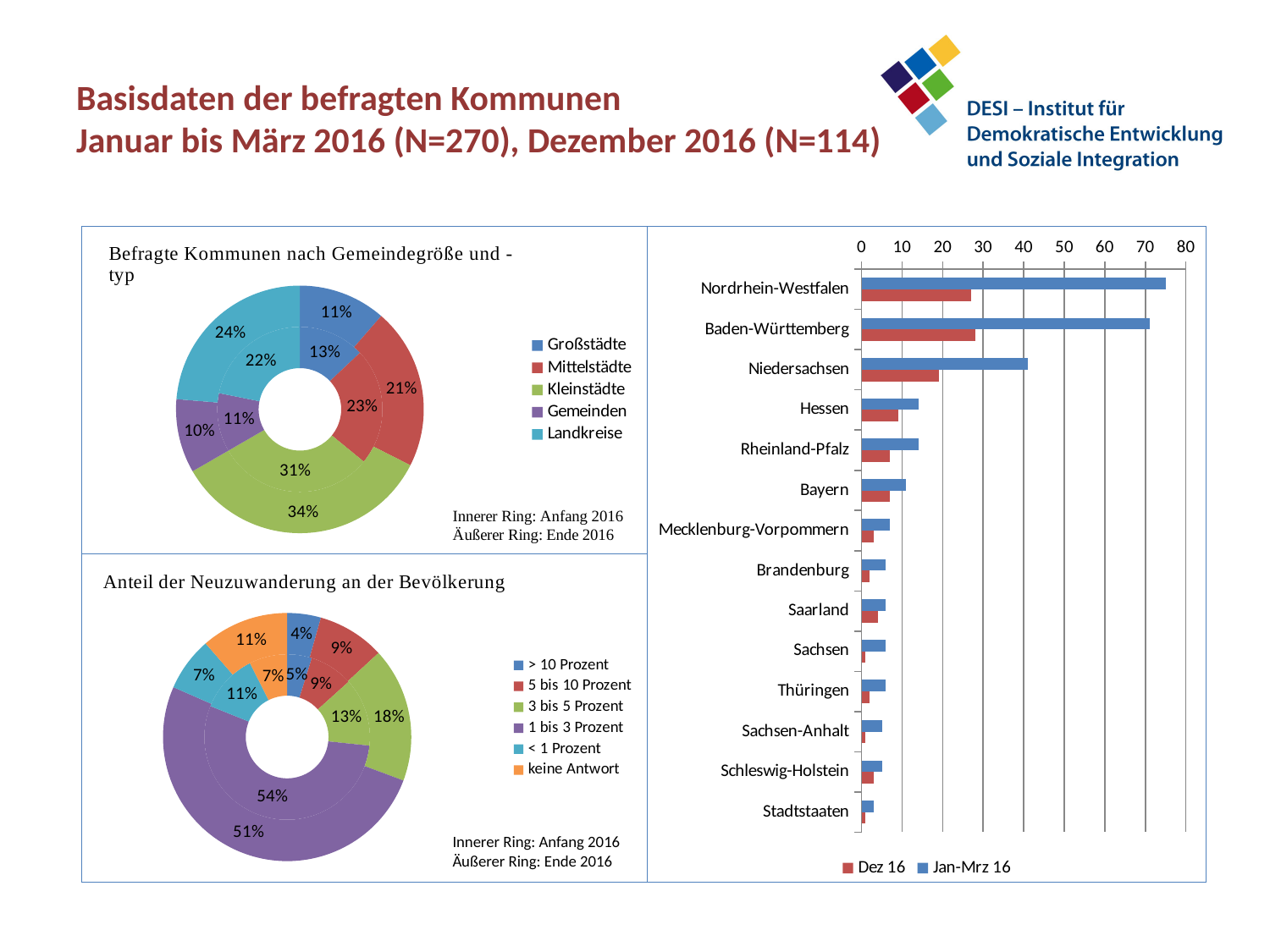
In the doughnut chart 'Befragte Kommunen nach Gemeindegröße und -typ', by how many percentage points did the share of Kleinstädte change from the inner ring (Anfang 2016) to the outer ring (Ende 2016)? 3 percentage points In the doughnut chart 'Befragte Kommunen nach Gemeindegröße und -typ', what is the share of Kleinstädte in the outer ring (Ende 2016)? 34% In the doughnut chart 'Anteil der Neuzuwanderung an der Bevölkerung', what is the share of '3 bis 5 Prozent' in the outer ring (Ende 2016)? 18% In the bar chart on the right, which federal state has the highest value for Jan-Mrz 16? Nordrhein-Westfalen In the doughnut chart 'Anteil der Neuzuwanderung an der Bevölkerung', which is larger in the outer ring (Ende 2016): '3 bis 5 Prozent' or '< 1 Prozent'? 3 bis 5 Prozent What kind of chart is the chart on the right side of the slide showing the federal states? Bar chart In the doughnut chart 'Befragte Kommunen nach Gemeindegröße und -typ', which category has the smallest share in the outer ring (Ende 2016)? Gemeinden In the doughnut chart 'Befragte Kommunen nach Gemeindegröße und -typ', what is the share of Landkreise in the inner ring (Anfang 2016)? 22% In the doughnut chart 'Anteil der Neuzuwanderung an der Bevölkerung', which category has the largest share in the inner ring (Anfang 2016)? 1 bis 3 Prozent How many legend entries does the doughnut chart 'Anteil der Neuzuwanderung an der Bevölkerung' list? 6 In the bar chart on the right, is the Jan-Mrz 16 value for Niedersachsen greater or less than 30? greater How many categories (federal states/groups) are shown in the bar chart on the right? 14